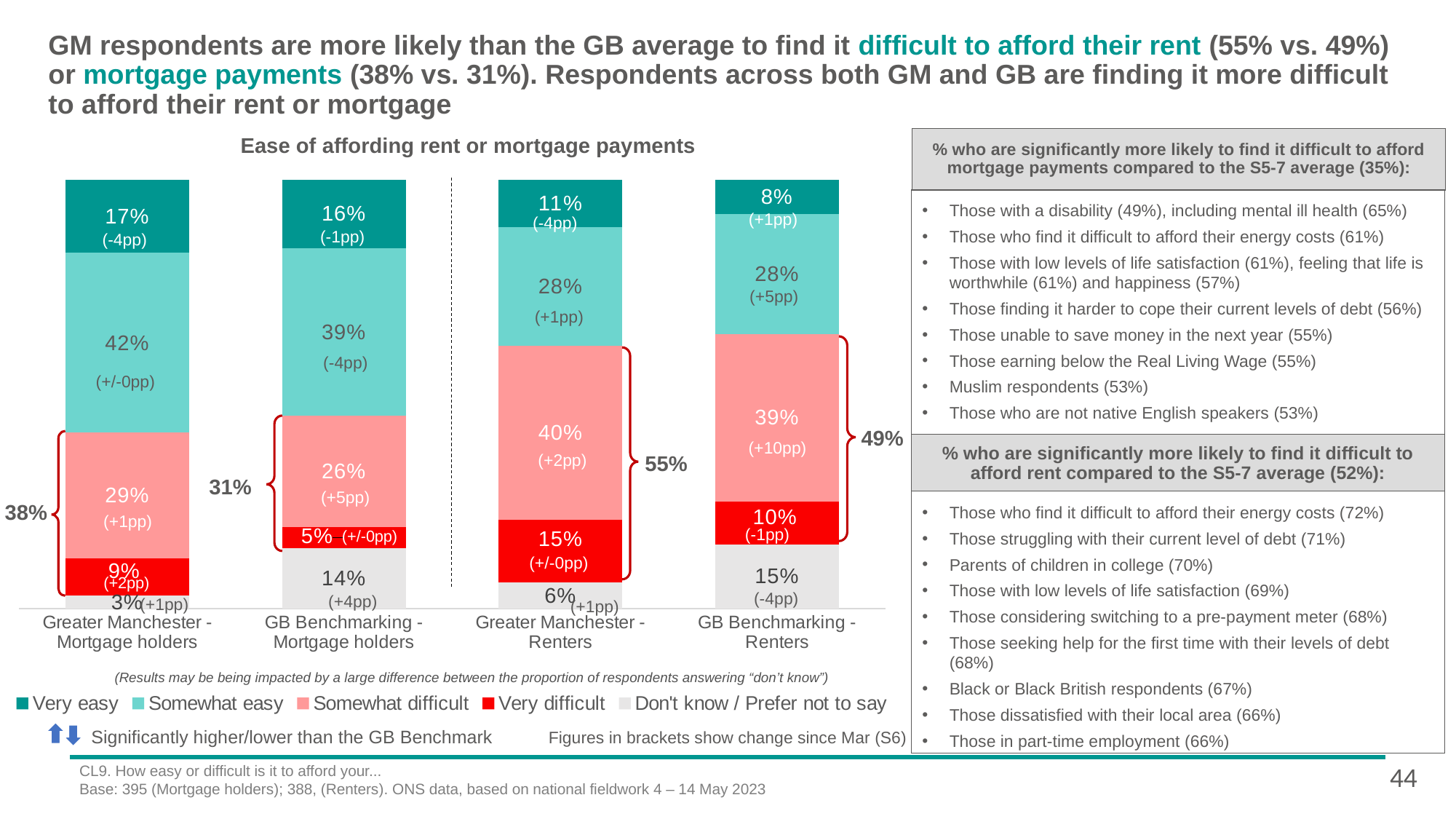
What is the 'Don't know / Prefer not to say' value for GB Benchmarking - Mortgage holders? 14% What is the 'Very difficult' value for Greater Manchester - Renters? 15% What is the combined 'Somewhat difficult' and 'Very difficult' total shown by the bracket for GB Benchmarking - Mortgage holders? 31% What is the 'Somewhat easy' value for Greater Manchester - Mortgage holders? 42% Which category has the highest 'Somewhat difficult' value? Greater Manchester - Renters What is the title of the chart? Ease of affording rent or mortgage payments How many series does the chart legend list? 5 What kind of chart is shown on the slide? Stacked bar chart How many categories (bars) are shown on the x axis of the chart? 4 What is the difference between the 'Very difficult' values for Greater Manchester - Renters and GB Benchmarking - Renters? 5 percentage points Which category has the lowest 'Very easy' value? GB Benchmarking - Renters Which is larger: the 'Somewhat easy' value for Greater Manchester - Mortgage holders or for GB Benchmarking - Mortgage holders? Greater Manchester - Mortgage holders